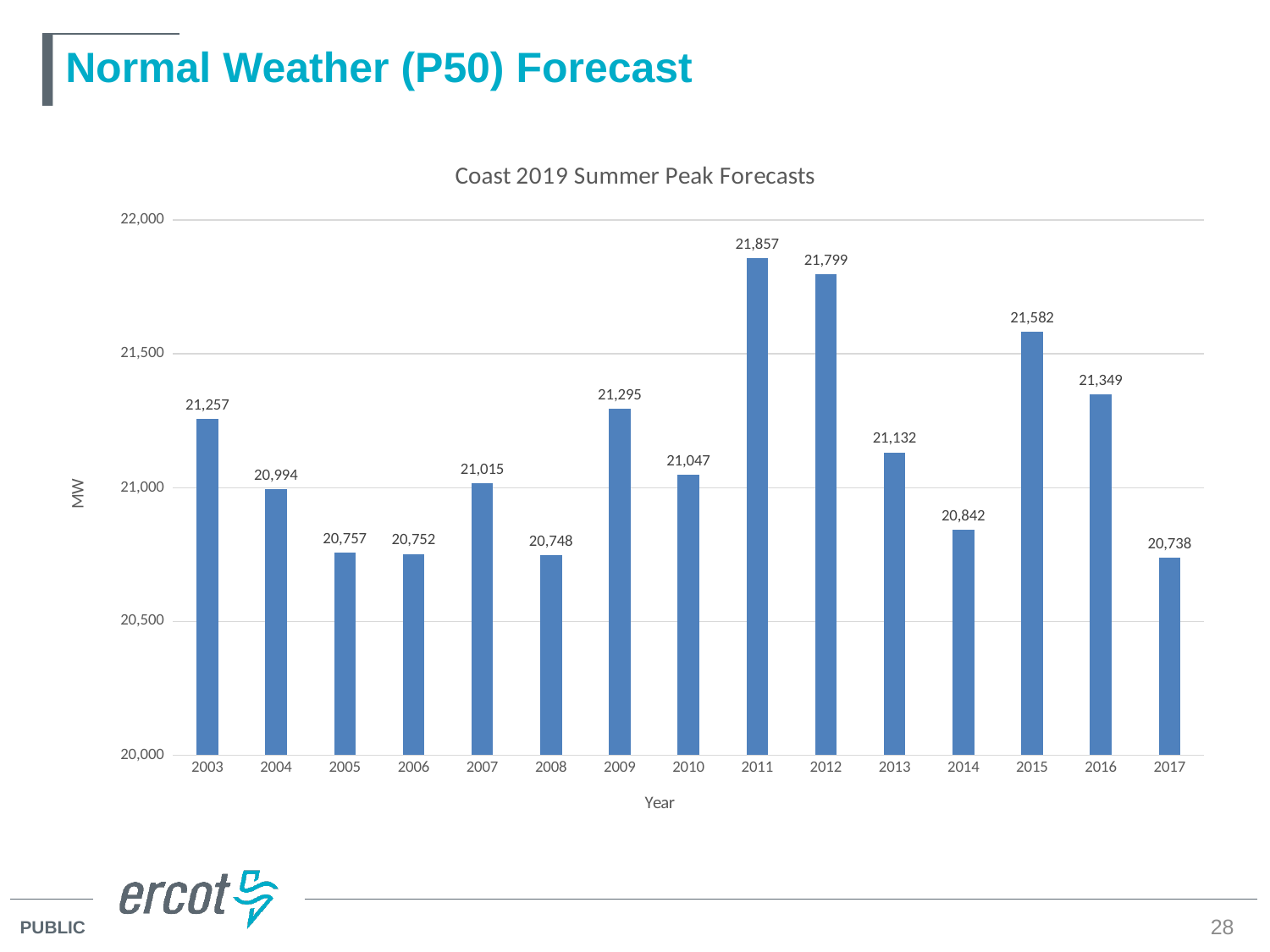
Which year has the lowest forecast value? 2017 What is the title of the chart? Coast 2019 Summer Peak Forecasts What is the difference between the 2015 and 2014 forecast values? 740 What is the forecast value shown for 2003? 21,257 How many years are shown on the x axis? 15 What is the forecast value shown for 2017? 20,738 What is the difference between the 2011 and 2012 forecast values? 58 Is the forecast value for 2016 greater or less than 21,500? less What is the Coast 2019 Summer Peak Forecast value for 2011? 21,857 Which year has the highest forecast value? 2011 Which is larger, the forecast value for 2009 or for 2013? 2009 What kind of chart is shown on the slide? bar chart